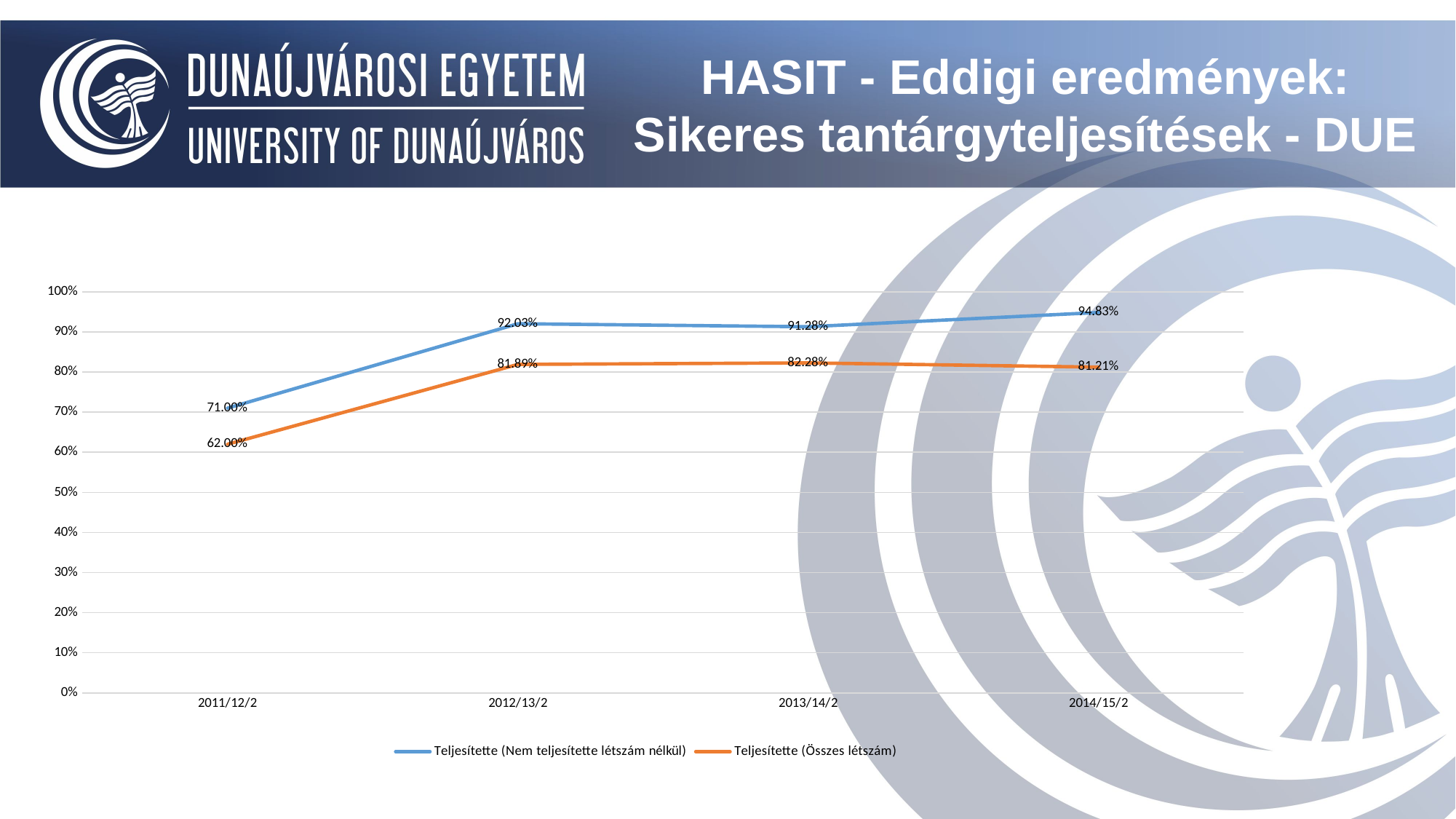
What is the value of Teljesítette (Nem teljesítette létszám nélkül) for 2011/12/2? 71.00% In which semester is Teljesítette (Összes létszám) highest? 2013/14/2 How many semesters are shown on the x axis? 4 What is the difference between the two series in 2011/12/2? 9.00% What is the value of Teljesítette (Összes létszám) for 2013/14/2? 82.28% Which series has the higher value in 2012/13/2? Teljesítette (Nem teljesítette létszám nélkül) What type of chart is shown on the slide? line chart In which semester is Teljesítette (Nem teljesítette létszám nélkül) lowest? 2011/12/2 What is the difference between the two series in 2014/15/2? 13.62% How many series does the legend list? 2 Does Teljesítette (Összes létszám) rise or fall from 2011/12/2 to 2012/13/2? rise What is the value of Teljesítette (Nem teljesítette létszám nélkül) for 2014/15/2? 94.83%